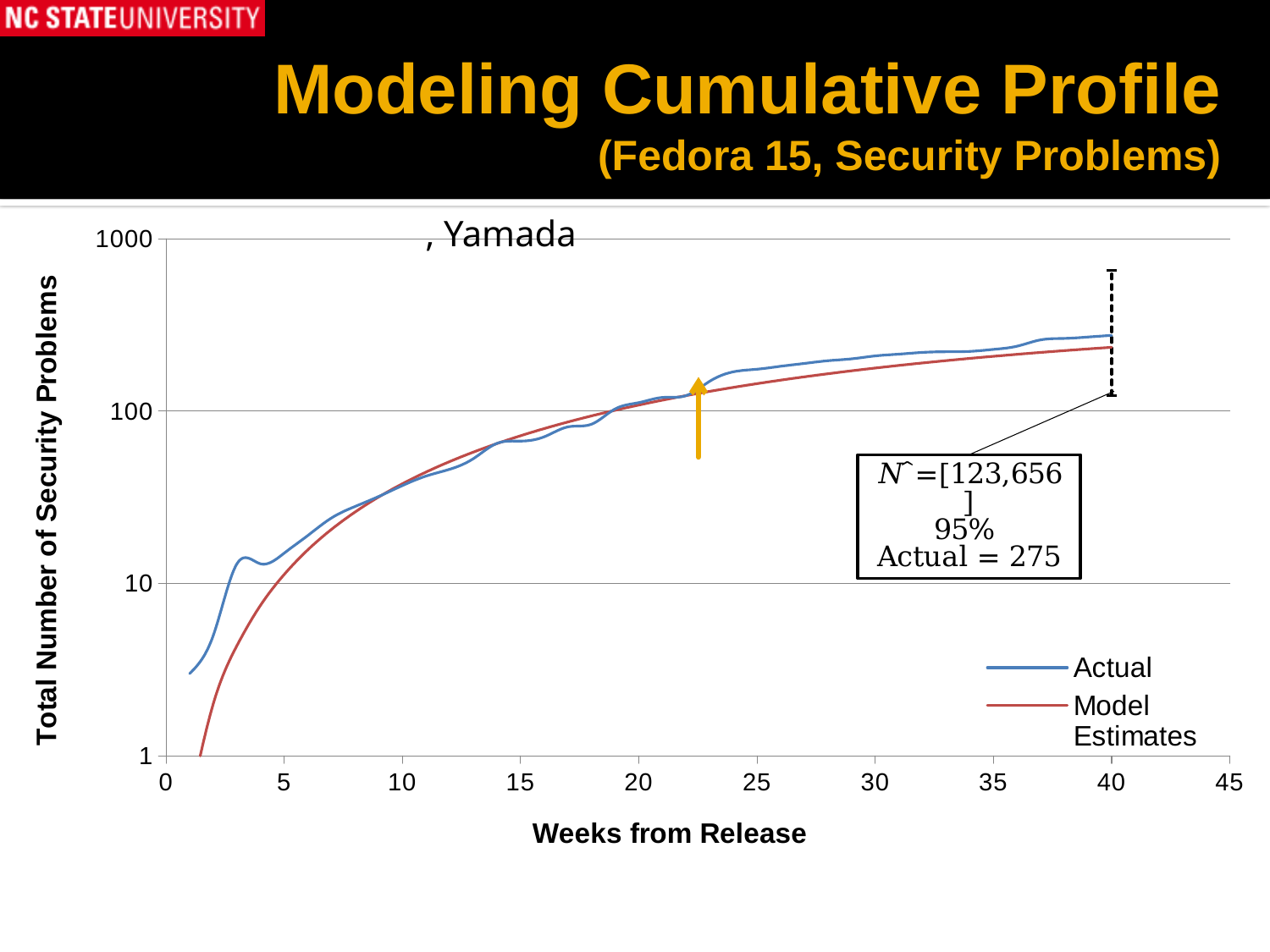
How many series does the legend list? 2 Is the Model Estimates value at week 30 greater or less than 100? greater At week 40, which series has the higher value, Actual or Model Estimates? Actual What kind of chart is shown on the slide? line chart At week 3, which series has the higher value, Actual or Model Estimates? Actual What are the two series named in the legend? Actual and Model Estimates Is the Actual value at week 40 greater or less than 100? greater Is the Actual value at week 1 greater or less than 10? less What is the title of the x axis? Weeks from Release According to the annotation box, what is the Actual total number of security problems? 275 Do the Actual values rise or fall as weeks from release increase? rise